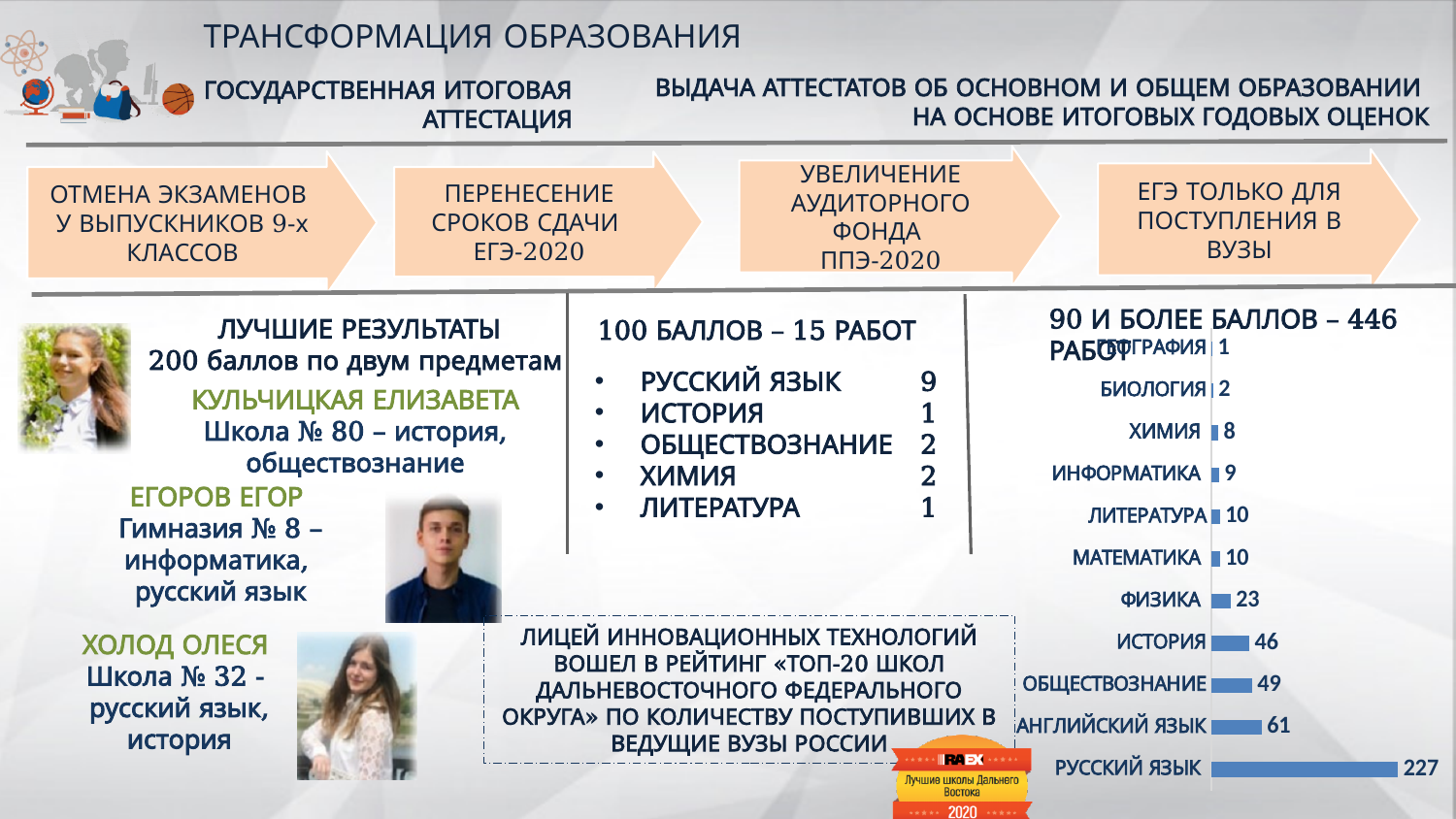
In the bar chart, what is the difference between the values for РУССКИЙ ЯЗЫК and АНГЛИЙСКИЙ ЯЗЫК? 166 What is the title of the bar chart? 90 И БОЛЕЕ БАЛЛОВ – 446 РАБОТ How many categories are shown in the bar chart? 11 In the bar chart, what is the value for РУССКИЙ ЯЗЫК? 227 In the bar chart, what is the value for ИНФОРМАТИКА? 9 Which category has the highest value in the bar chart? РУССКИЙ ЯЗЫК In the bar chart, what is the value for ФИЗИКА? 23 In the bar chart, which is larger: the value for ИСТОРИЯ or the value for ФИЗИКА? ИСТОРИЯ Which category has the lowest value in the bar chart? ГЕОГРАФИЯ In the bar chart, what is the value for АНГЛИЙСКИЙ ЯЗЫК? 61 What type of chart is shown on the right side of the slide? bar chart In the bar chart, what is the difference between the values for ОБЩЕСТВОЗНАНИЕ and ИСТОРИЯ? 3